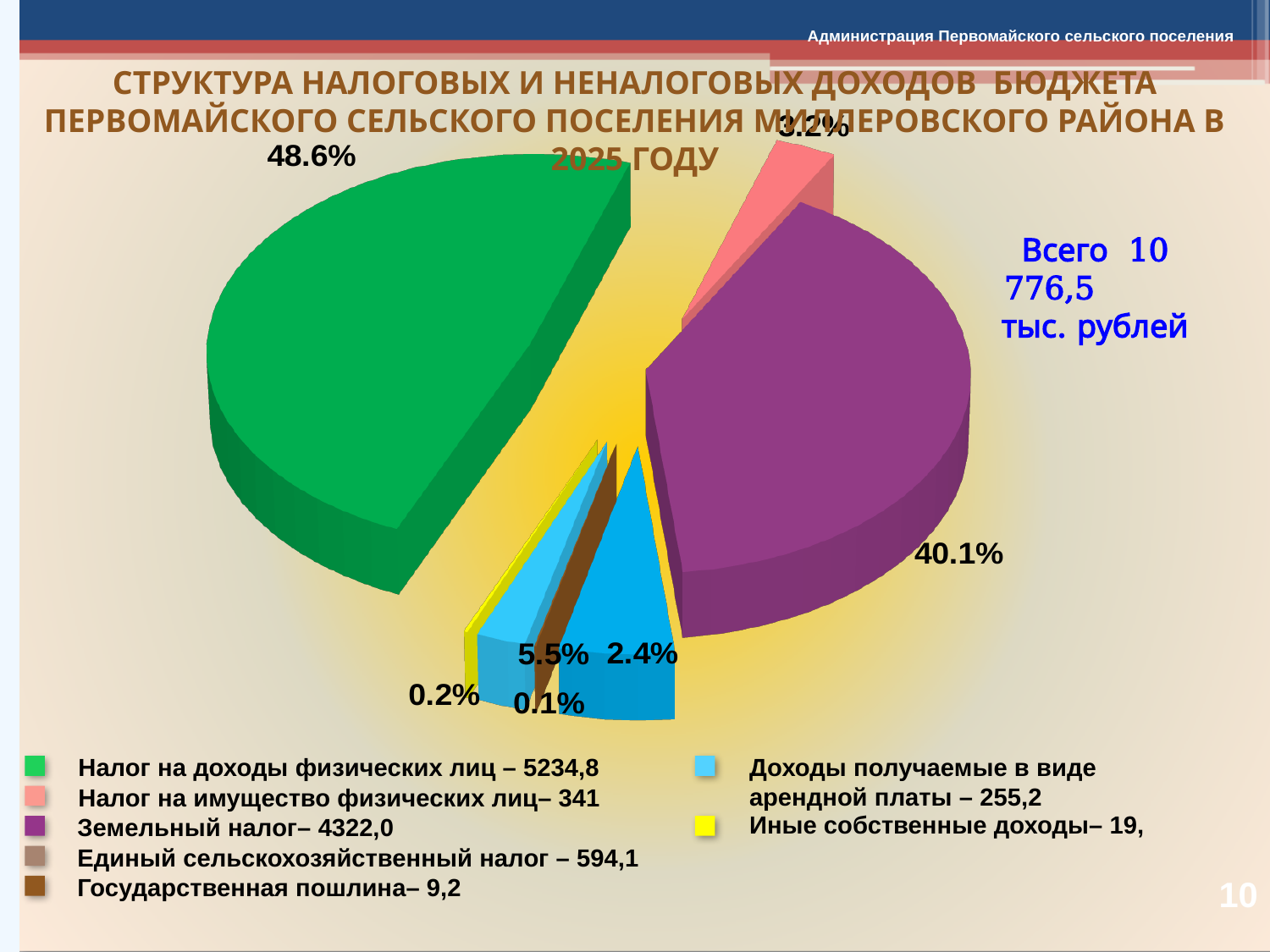
What share of the pie does Земельный налог (purple slice) have? 40.1% How many categories does the legend of the pie chart list? 7 Which is larger: Налог на доходы физических лиц or Земельный налог? Налог на доходы физических лиц What kind of chart is shown on the slide? Pie chart What total amount is stated next to the pie chart? 10 776,5 тыс. рублей What value does the legend give for Земельный налог? 4322,0 What is the difference in percentage points between the 48.6% slice and the 40.1% slice? 8.5 What share of the pie does Налог на имущество физических лиц (pink slice) have? 3.2% Which category has the largest slice of the pie chart? Налог на доходы физических лиц What value does the legend give for Доходы получаемые в виде арендной платы? 255,2 What share of the pie does Налог на доходы физических лиц (green slice) have? 48.6% What value does the legend give for Единый сельскохозяйственный налог? 594,1